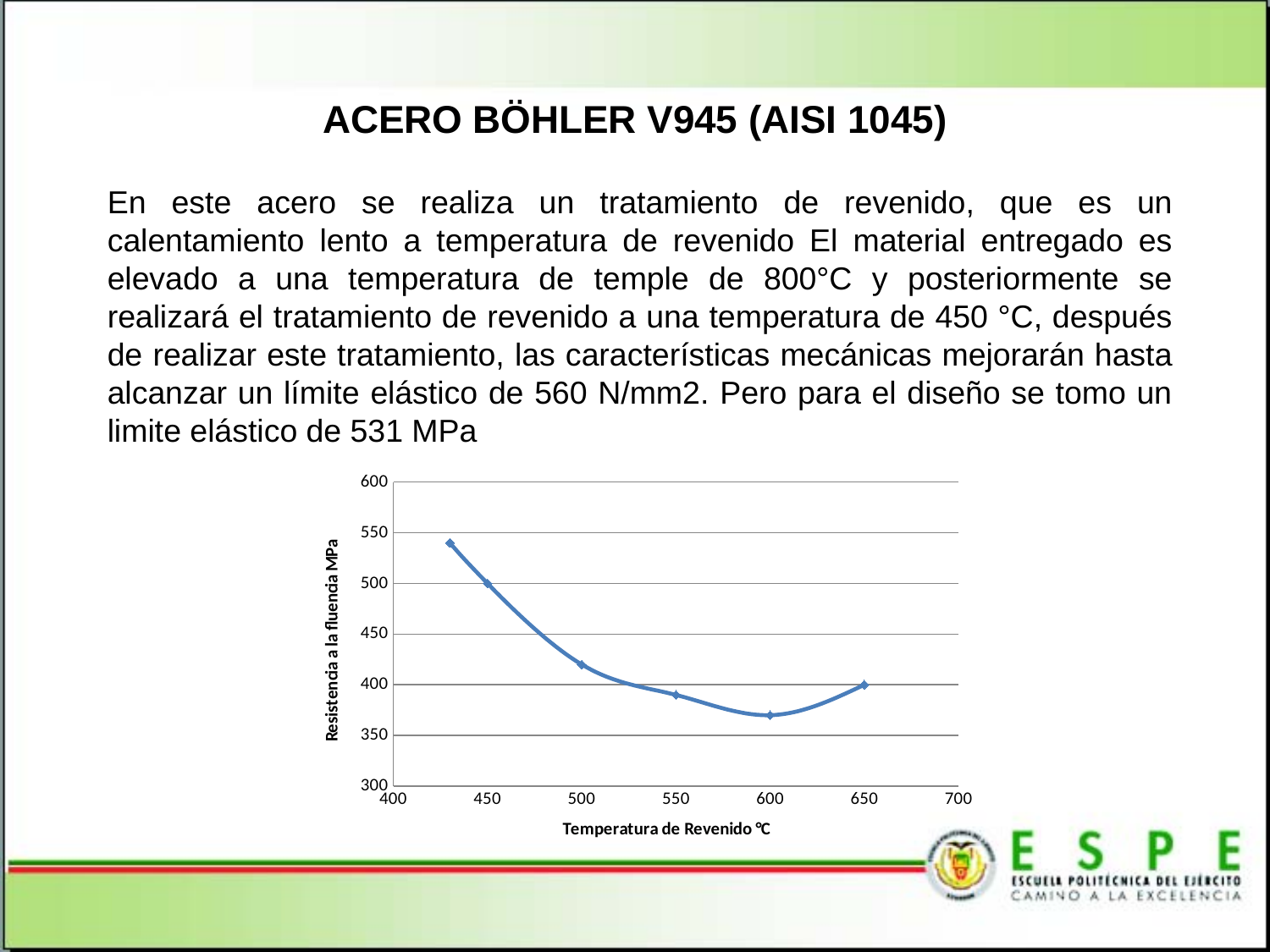
Does the Resistencia a la fluencia rise or fall as the Temperatura de Revenido increases from 450 °C to 600 °C? fall What is the Resistencia a la fluencia value at a Temperatura de Revenido of 650 °C? 400 Is the Resistencia a la fluencia at 550 °C greater or less than 450? less Is the Resistencia a la fluencia at 600 °C greater or less than 400? less What is the title of the vertical axis of the chart? Resistencia a la fluencia MPa How many data points are plotted on the chart? 6 Which has a higher Resistencia a la fluencia: 450 °C or 650 °C? 450 °C What kind of chart is shown on the slide? line chart At which Temperatura de Revenido is the Resistencia a la fluencia lowest? 600 °C Is the Resistencia a la fluencia at 500 °C greater or less than 400? greater What is the Resistencia a la fluencia value at a Temperatura de Revenido of 450 °C? 500 What is the difference in Resistencia a la fluencia between 450 °C and 650 °C? 100